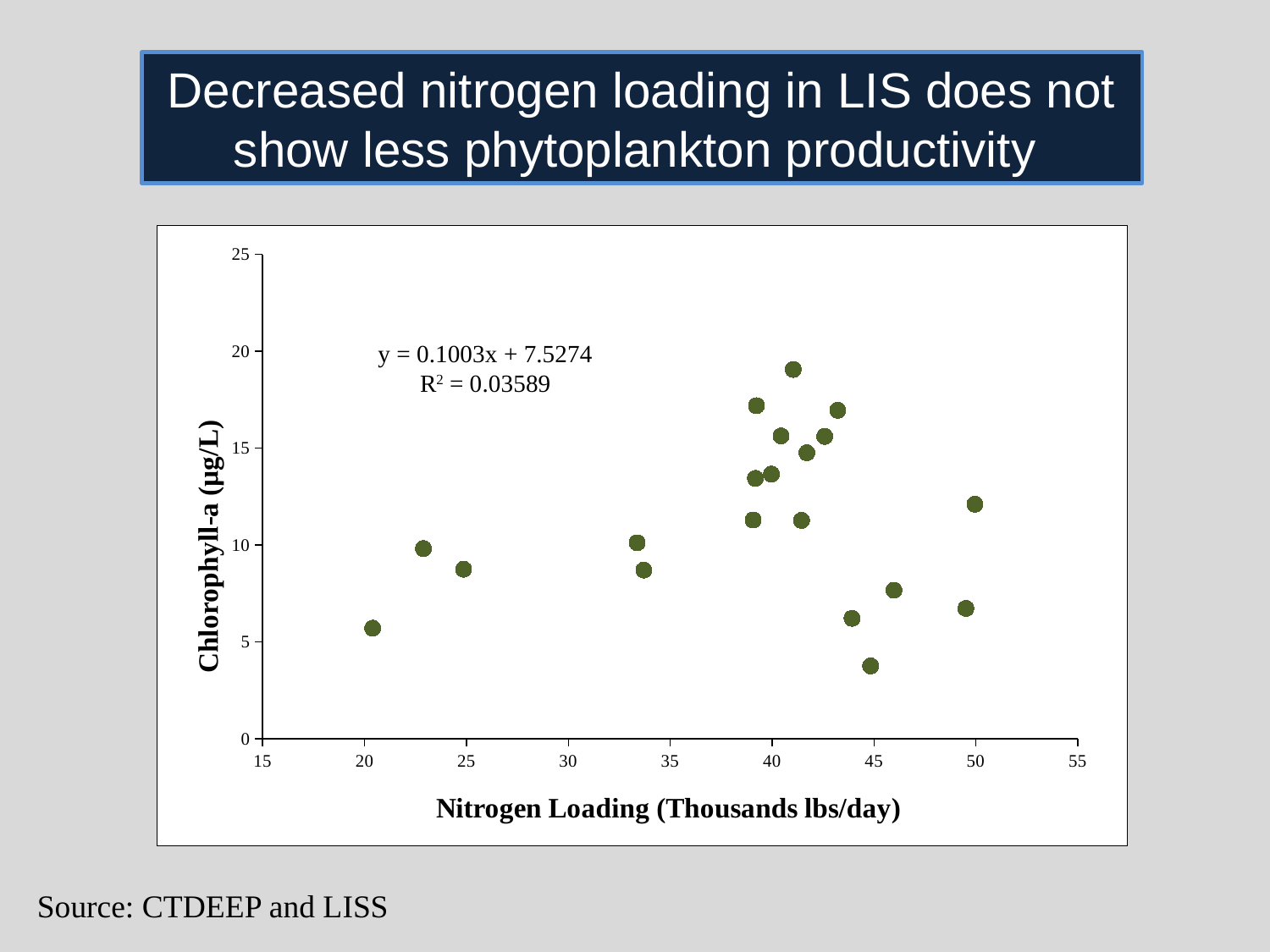
Is the lowest chlorophyll-a value plotted greater or less than 5 µg/L? less What is the highest tick value shown on the y axis? 25 What is the trend-line equation printed on the chart? y = 0.1003x + 7.5274 What kind of chart is shown on the slide? Scatter plot Is the chlorophyll-a value of the point with the lowest nitrogen loading (around 20 thousand lbs/day) greater or less than 10 µg/L? less What is the label of the x axis? Nitrogen Loading (Thousands lbs/day) What R² value is printed on the chart? 0.03589 Is the highest chlorophyll-a value plotted greater or less than 15 µg/L? greater According to the fitted trend line, does chlorophyll-a rise or fall as nitrogen loading increases? Rises (slightly) What is the title of the slide's chart? Decreased nitrogen loading in LIS does not show less phytoplankton productivity How many data points are plotted on the chart? 20